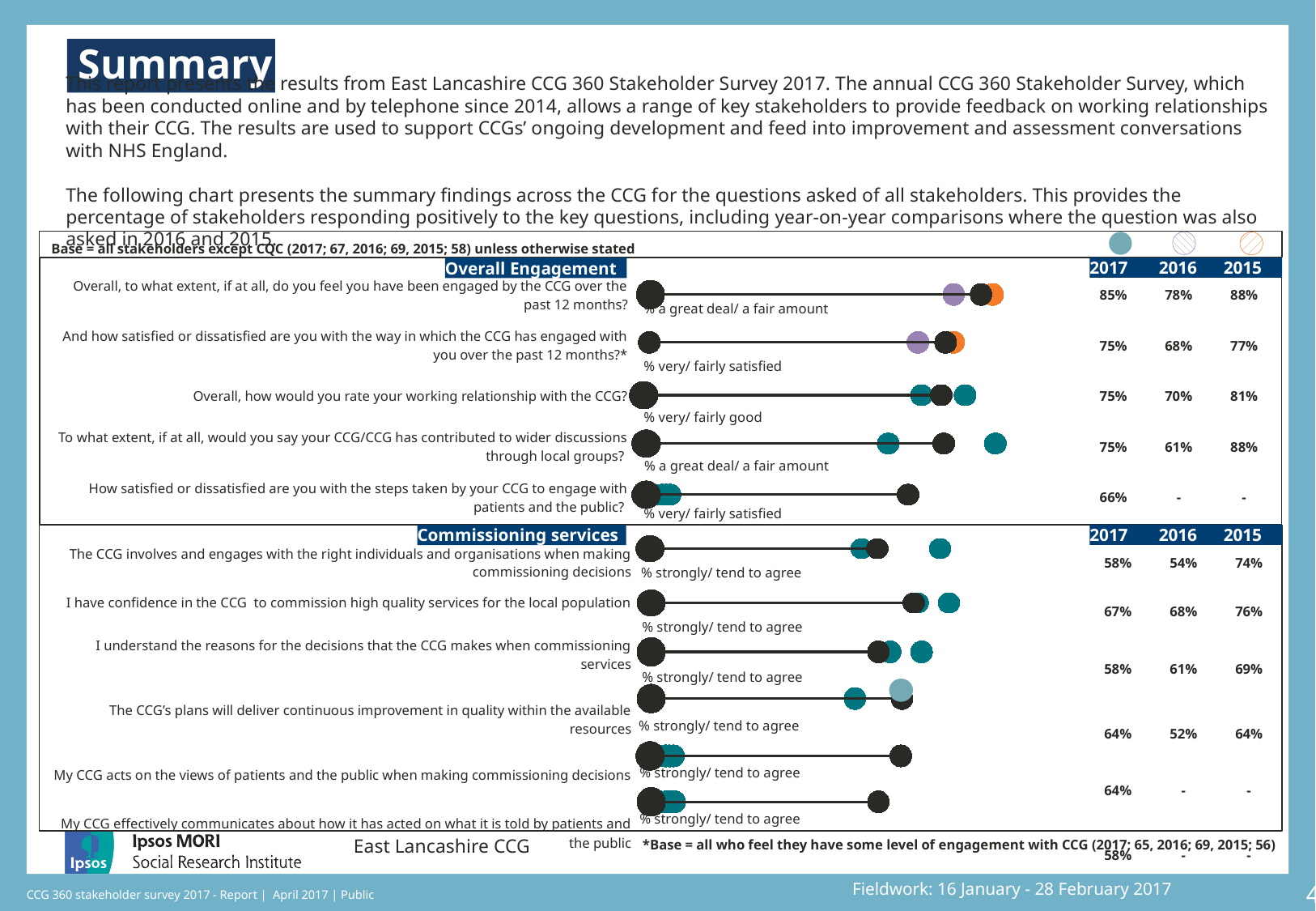
What percentage of stakeholders in 2017 agreed that the CCG's plans will deliver continuous improvement in quality within the available resources? 64% How many questions are listed under the Commissioning services section of the chart? 6 What was the 2015 value for stakeholders saying the CCG contributed a great deal or a fair amount to wider discussions through local groups? 88% How many years does the legend at the top of the chart list? 3 What kind of chart is used to show the year-on-year comparisons on this slide? dot plot In 2016, what percentage of stakeholders said they were very or fairly satisfied with the way the CCG engaged with them over the past 12 months? 68% Which year had the lowest percentage agreeing that the CCG involves and engages with the right individuals and organisations when making commissioning decisions? 2016 Was the 2017 value for understanding the reasons for the CCG's commissioning decisions higher or lower than the 2016 value? lower What is the difference between the 2015 and 2017 values for stakeholders having confidence in the CCG to commission high quality services for the local population? 9 percentage points By how many percentage points did the share of stakeholders feeling engaged by the CCG change from 2016 to 2017? 7 percentage points Which year had the highest percentage of stakeholders rating their working relationship with the CCG as very or fairly good? 2015 What percentage of stakeholders in 2017 felt they had been engaged by the CCG a great deal or a fair amount over the past 12 months? 85%